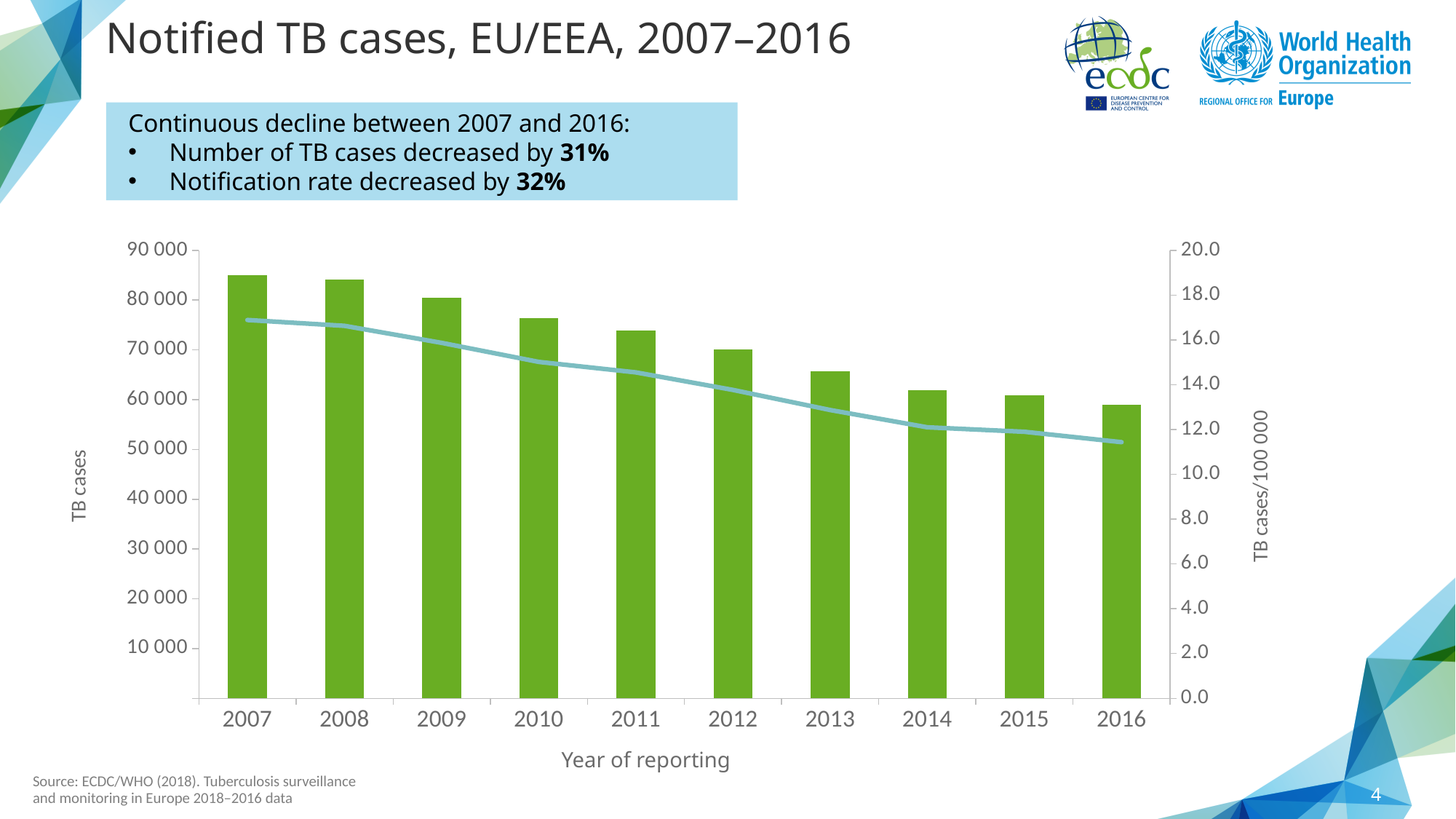
Is the notification rate (TB cases/100 000) in 2016 greater or less than 12.0? less What is the label of the right-hand vertical axis of the chart? TB cases/100 000 What is the title of the chart on the slide? Notified TB cases, EU/EEA, 2007–2016 Is the number of TB cases in 2012 greater or less than 60 000? greater Which year has more TB cases, 2009 or 2013? 2009 What kind of chart is shown on the slide? A bar chart with a line Which year has the highest number of TB cases in the chart? 2007 Do the number of TB cases rise or fall from 2007 to 2016? Fall Is the number of TB cases in 2007 greater or less than 80 000? greater Which year has the lowest number of TB cases in the chart? 2016 How many years are plotted on the x axis of the chart? 10